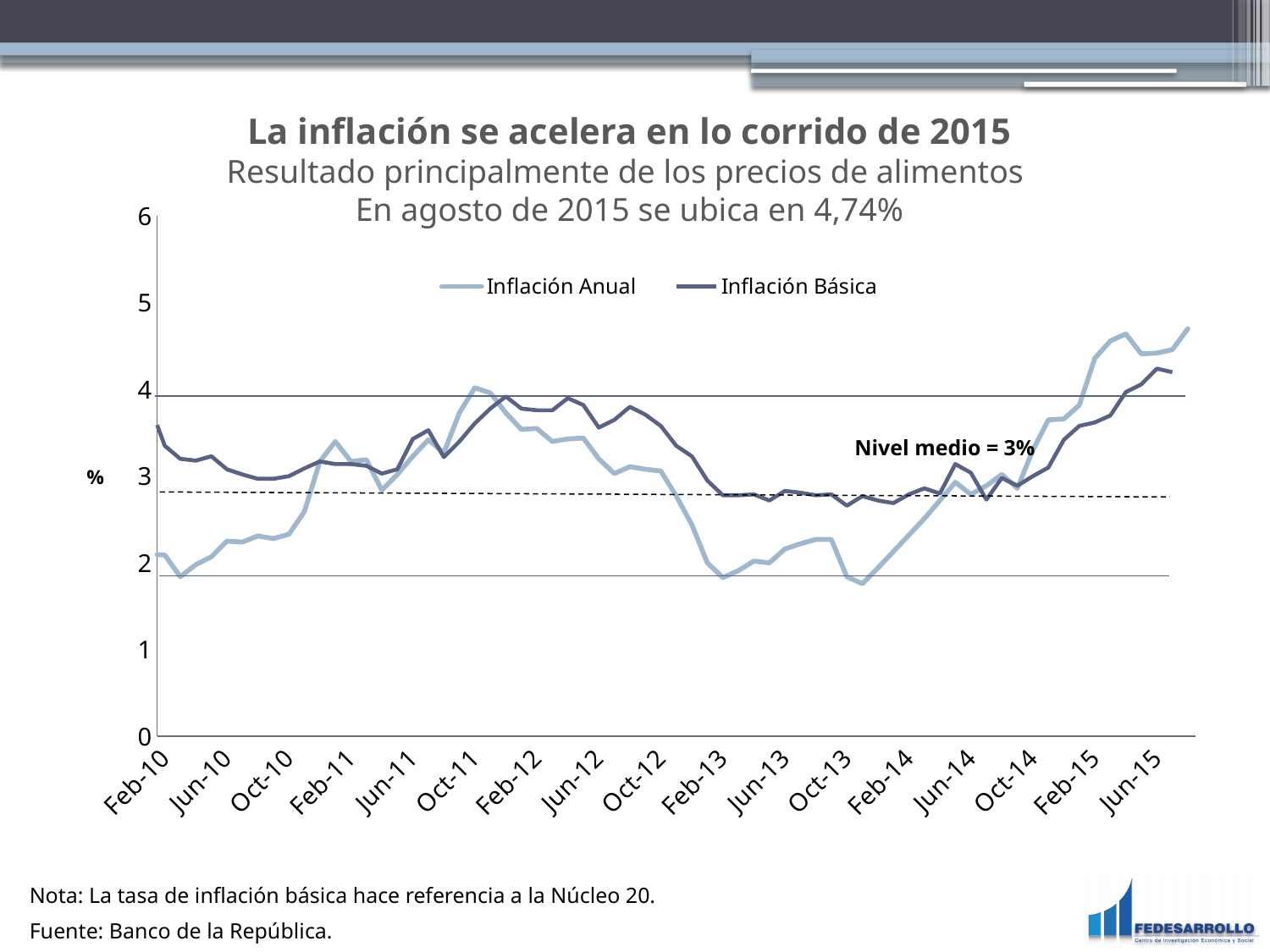
Is the value of Inflación Básica at Jun-12 greater or less than 3? greater How many series does the legend list? 2 What level does the dashed horizontal line in the chart represent, according to its label? Nivel medio = 3% What kind of chart is shown on the slide? line chart At Oct-13, which series has the higher value, Inflación Anual or Inflación Básica? Inflación Básica Is the value of Inflación Anual at Oct-13 greater or less than 2? less Is the value of Inflación Básica at Feb-10 greater or less than 3? greater At Oct-11, which series has the higher value, Inflación Anual or Inflación Básica? Inflación Anual What are the two series named in the legend? Inflación Anual and Inflación Básica Does Inflación Anual rise or fall between Oct-13 and Jun-15? rise